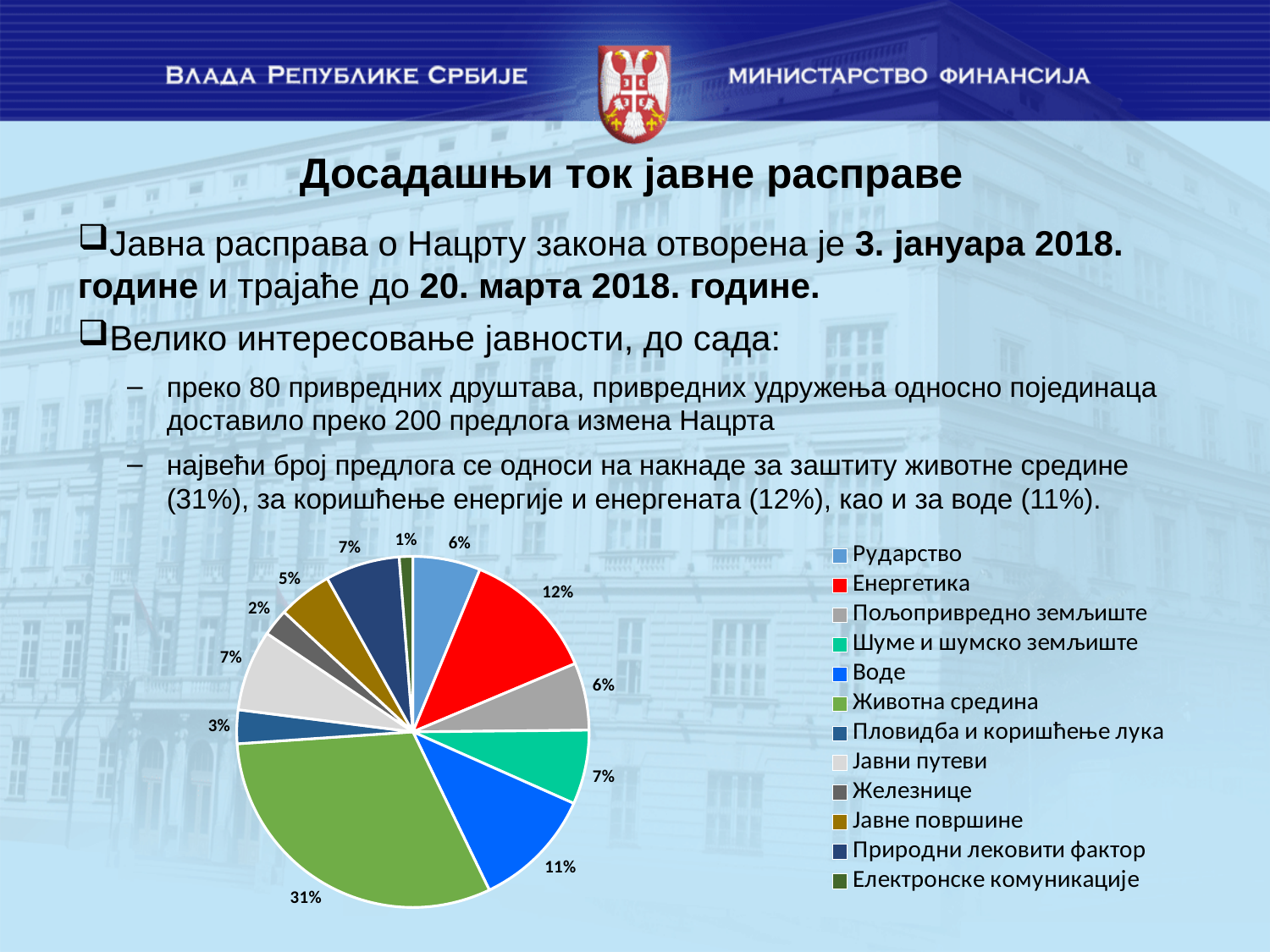
What is the difference in percentage points between Животна средина and Енергетика? 19 Which category has the largest slice of the pie? Животна средина How many categories does the pie chart's legend list? 12 Which category has the smallest slice of the pie? Електронске комуникације What share of the pie does Енергетика have? 12% What colour is the slice for Енергетика? red What share of the pie does Јавне површине have? 5% What kind of chart is shown on the slide? pie chart What share of the pie does Железнице have? 2% What share of the pie does Воде have? 11% What share of the pie does Животна средина have? 31% Which is larger, the share for Воде or the share for Пловидба и коришћење лука? Воде